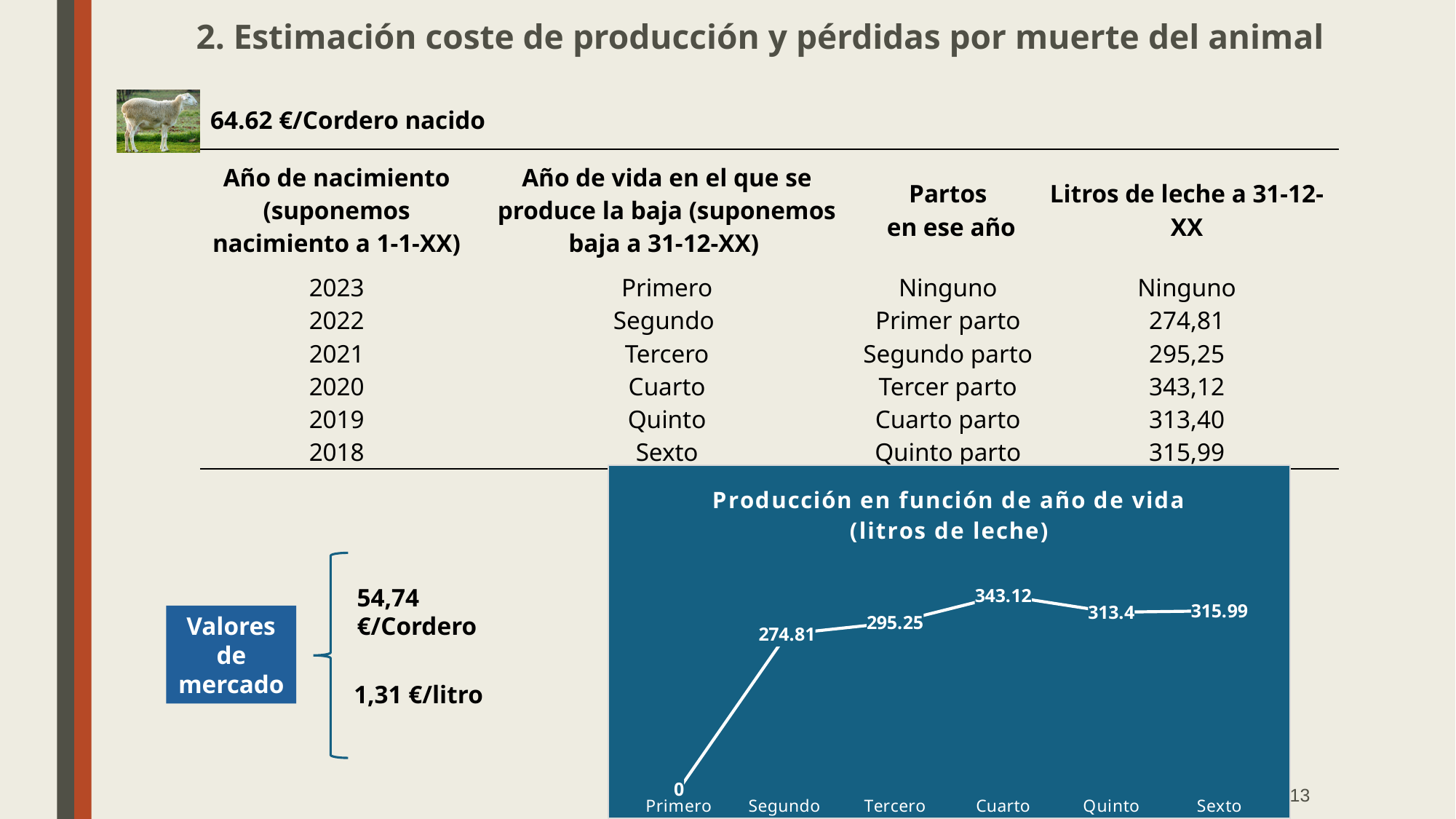
Which is larger, the value for Quinto or the value for Segundo? Quinto What is the title of the chart? Producción en función de año de vida (litros de leche) What is the value for Segundo in the chart? 274.81 What is the difference between the values for Cuarto and Tercero? 47.87 How many data points are plotted in the chart? 6 What is the value for Cuarto in the chart? 343.12 What type of chart is shown on the slide? line chart Which category has the lowest value in the chart? Primero Does the value rise or fall from Cuarto to Quinto? fall Which category has the highest value in the chart? Cuarto What is the value for Primero in the chart? 0 What is the value for Sexto in the chart? 315.99